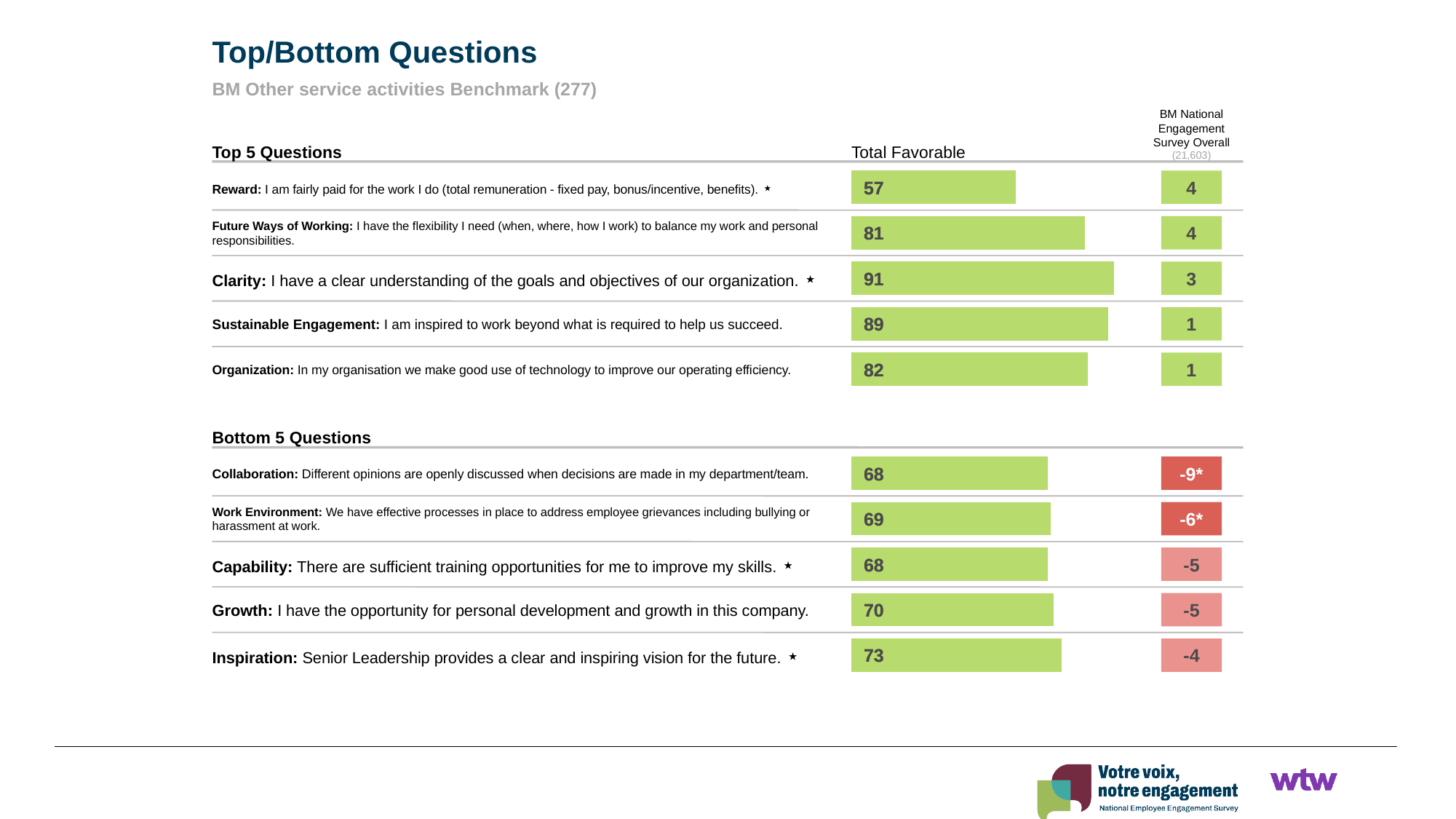
What kind of chart is used to show the Total Favorable values? Bar chart In the Top 5 Questions chart, what is the Total Favorable value for Reward? 57 In the Bottom 5 Questions chart, what is the BM National Engagement Survey Overall comparison value for Collaboration? -9* In the Bottom 5 Questions chart, which has a larger Total Favorable value, Growth or Work Environment? Growth In the Top 5 Questions chart, what is the difference in Total Favorable between Clarity and Reward? 34 In the Top 5 Questions chart, what is the BM National Engagement Survey Overall comparison value for Sustainable Engagement? 1 In the Top 5 Questions chart, what is the Total Favorable value for Clarity? 91 In the Top 5 Questions chart, which question has the lowest Total Favorable value? Reward How many questions are shown in the Bottom 5 Questions chart? 5 In the Top 5 Questions chart, which question has the highest Total Favorable value? Clarity In the Bottom 5 Questions chart, which question has the highest Total Favorable value? Inspiration In the Bottom 5 Questions chart, what is the Total Favorable value for Inspiration? 73